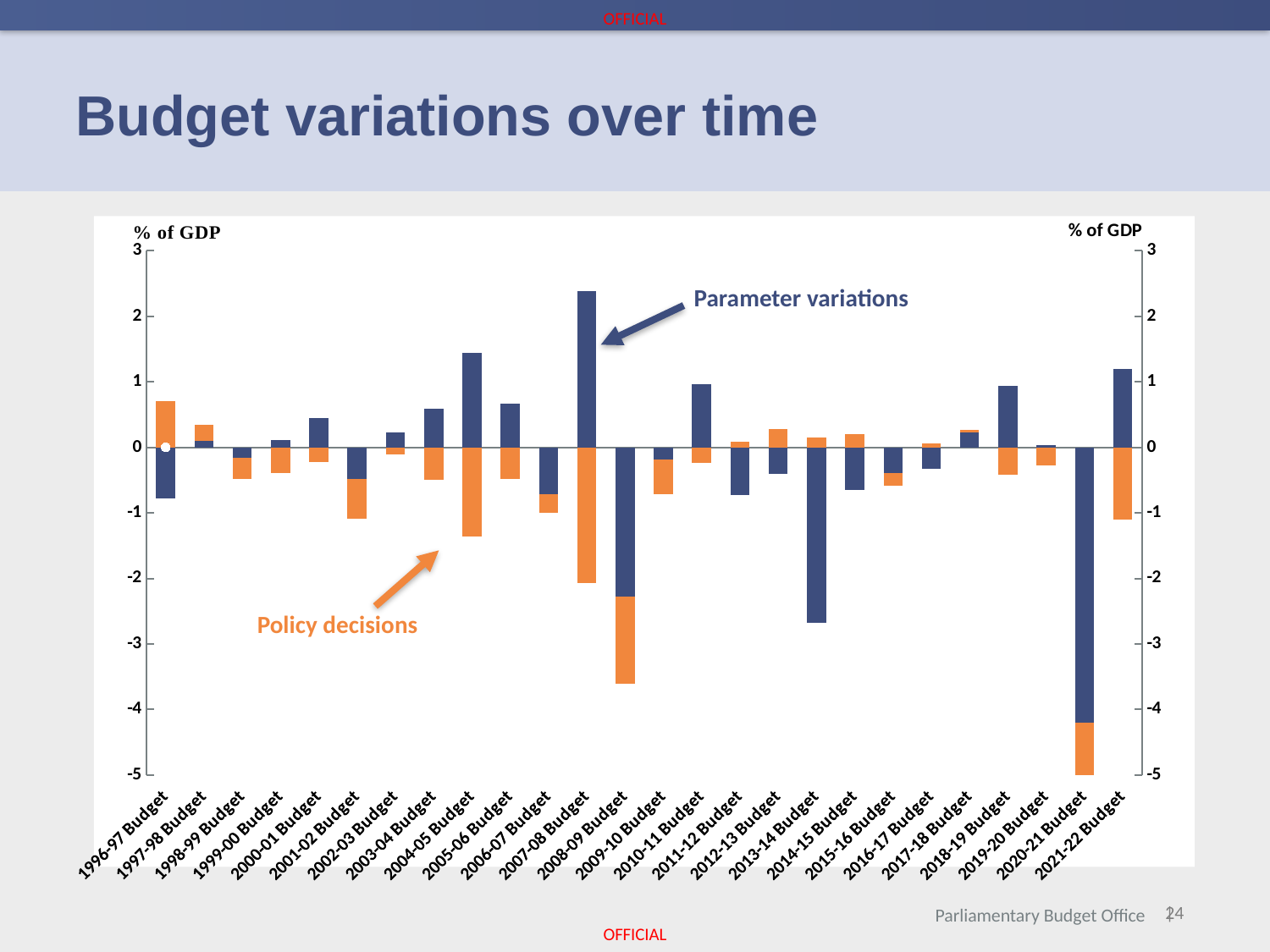
Which budget has the highest positive parameter variation? 2007-08 Budget How many budget years are shown along the x axis of the chart? 26 Is the policy decisions value for the 2004-05 Budget greater or less than -1? less Which budget has the lowest (most negative) parameter variation? 2020-21 Budget What kind of chart is shown on the slide? bar chart Which has the larger parameter variation, the 2007-08 Budget or the 2004-05 Budget? 2007-08 Budget Is the parameter variations value for the 2007-08 Budget greater or less than 2? greater Is the parameter variations value for the 2020-21 Budget greater or less than -3? less Which series is shown in orange in the chart? Policy decisions How many data series are plotted in the chart? 2 What unit is shown on the vertical axis of the chart? % of GDP